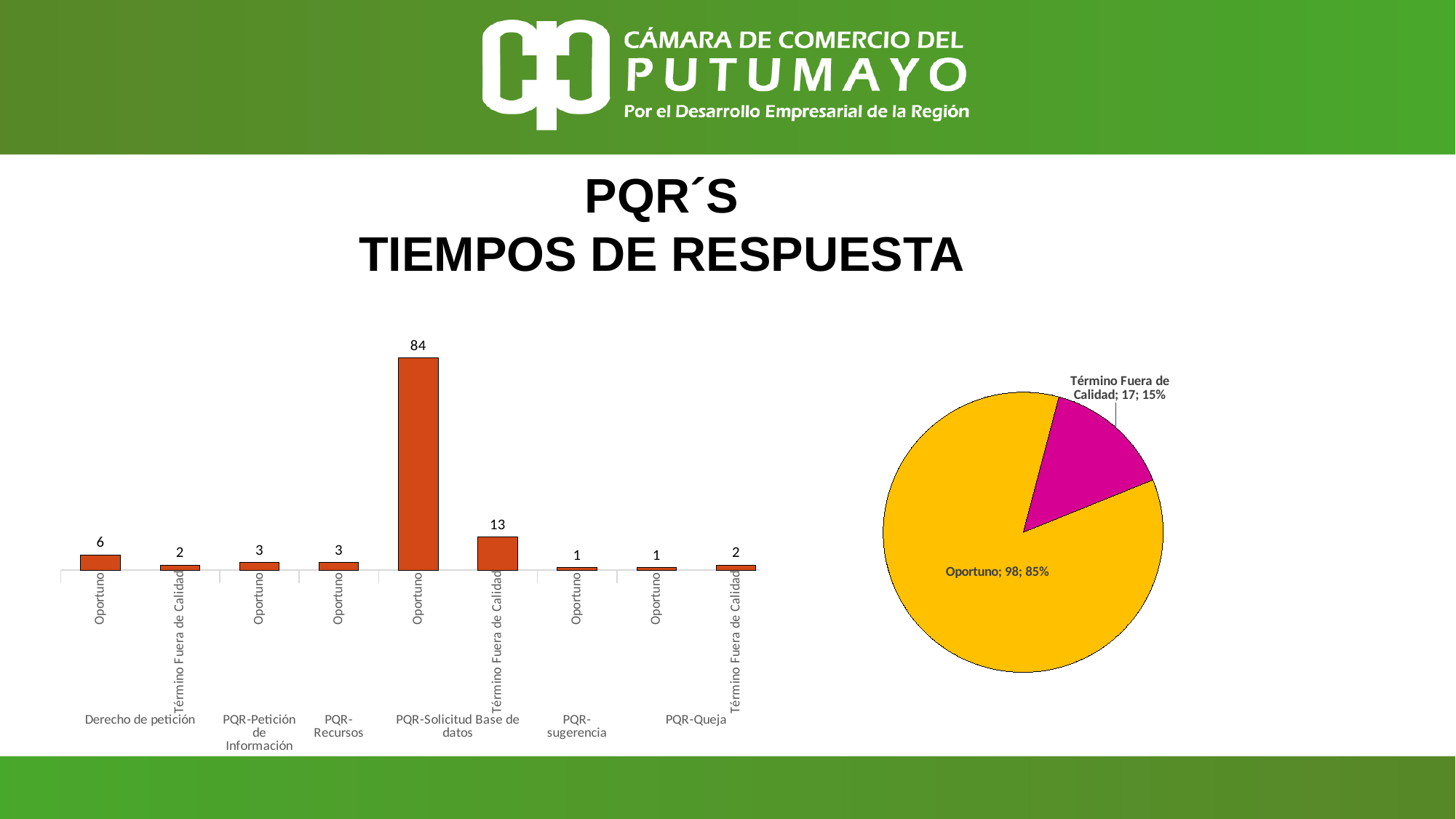
How many bars are plotted in the bar chart on the left? 9 In the bar chart on the left, what is the value for Término Fuera de Calidad under Derecho de petición? 2 In the bar chart on the left, what is the difference between the Oportuno and Término Fuera de Calidad values under PQR-Solicitud Base de datos? 71 In the pie chart on the right, what share does Término Fuera de Calidad represent? 15% In the bar chart on the left, what is the value for Oportuno under PQR-Solicitud Base de datos? 84 What kind of chart is shown on the left of the slide? Bar chart In the bar chart on the left, which is larger: Oportuno under Derecho de petición or Oportuno under PQR-Recursos? Oportuno under Derecho de petición In the bar chart on the left, which bar has the highest value? Oportuno under PQR-Solicitud Base de datos In the pie chart on the right, what is the value for Oportuno? 98 In the bar chart on the left, what is the value for Oportuno under PQR-Queja? 1 What is the title of the slide? PQR´S TIEMPOS DE RESPUESTA In the pie chart on the right, what is the difference between the Oportuno and Término Fuera de Calidad values? 81